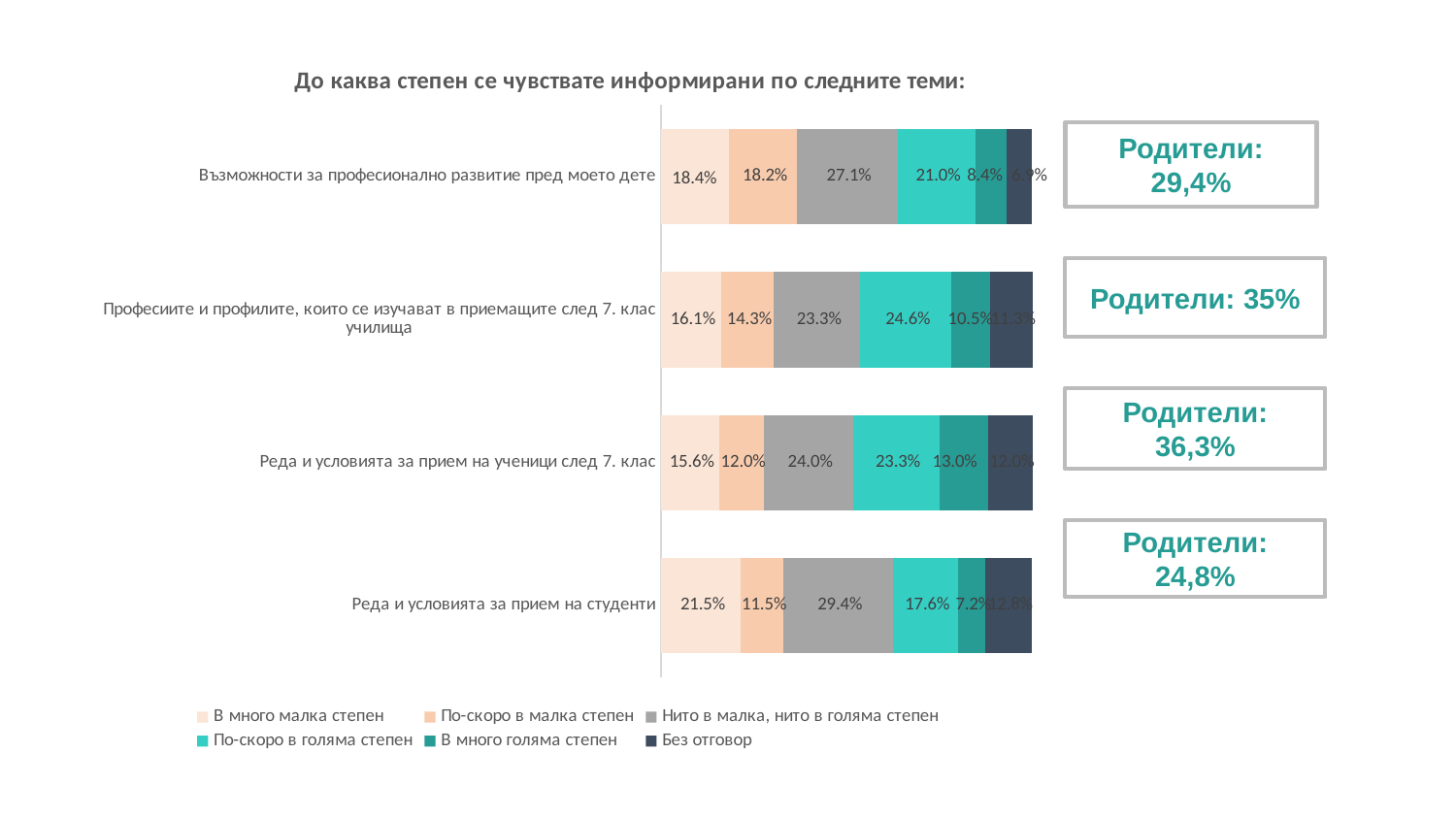
For "Възможности за професионално развитие пред моето дете", what is the difference between "Нито в малка, нито в голяма степен" and "В много малка степен"? 8.7 percentage points What kind of chart is shown on the slide? Stacked bar chart What is the value of "По-скоро в малка степен" for "Реда и условията за прием на ученици след 7. клас"? 12.0% Which has the larger value for "В много голяма степен": "Реда и условията за прием на ученици след 7. клас" or "Реда и условията за прием на студенти"? Реда и условията за прием на ученици след 7. клас Which category has the highest value for "В много малка степен"? Реда и условията за прием на студенти What is the title of the chart? До каква степен се чувствате информирани по следните теми: What is the value of "По-скоро в голяма степен" for "Професиите и профилите, които се изучават в приемащите след 7. клас училища"? 24.6% What is the value of "Нито в малка, нито в голяма степен" for "Възможности за професионално развитие пред моето дете"? 27.1% How many series does the chart legend list? 6 How many categories (topics) are plotted in the chart? 4 Which category has the lowest value for "Нито в малка, нито в голяма степен"? Професиите и профилите, които се изучават в приемащите след 7. клас училища What is the value of "В много малка степен" for "Реда и условията за прием на студенти"? 21.5%